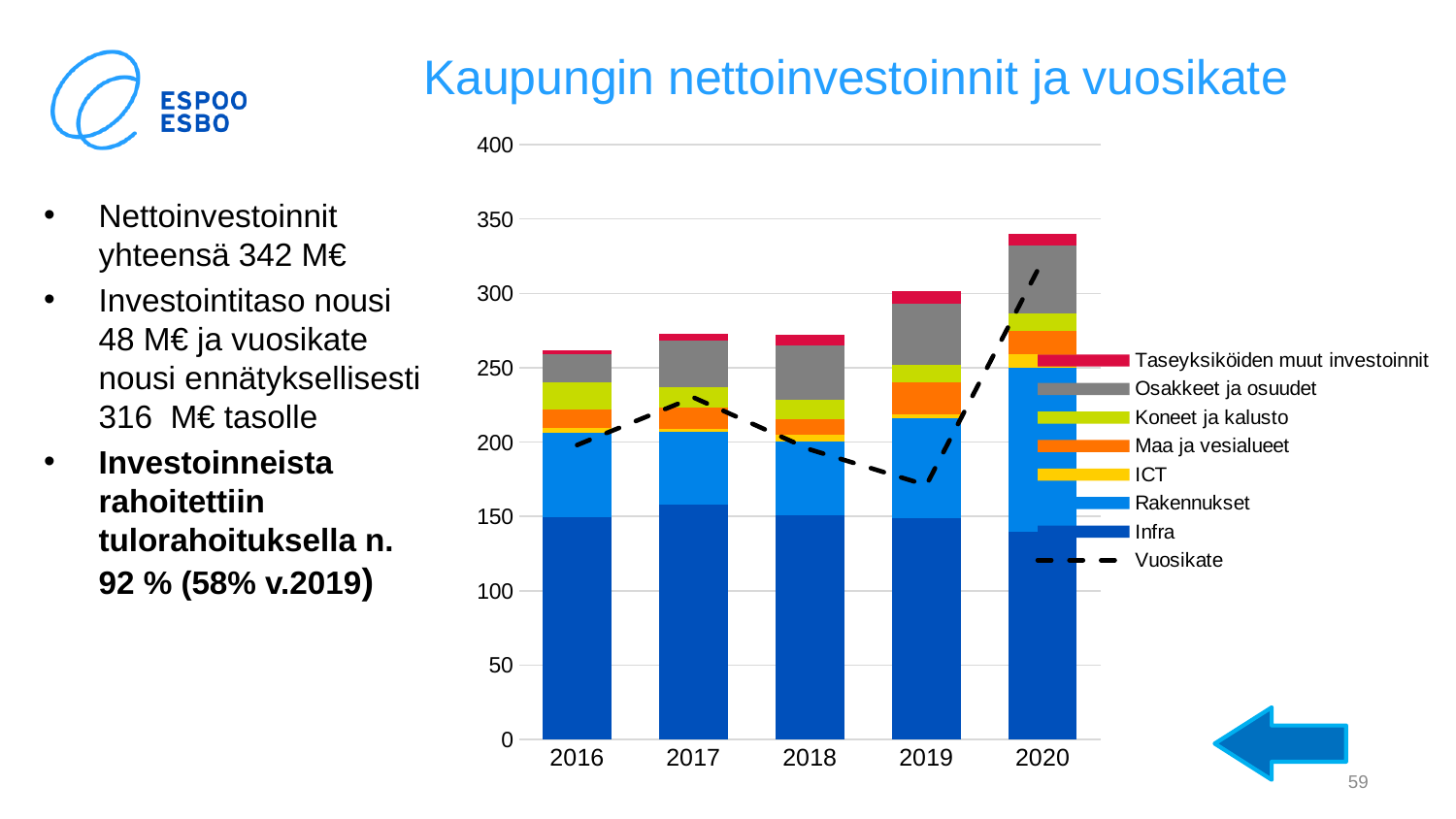
Is the Vuosikate value for 2019 greater or less than 200? less Which series is drawn as a dashed line in the chart? Vuosikate Is the Vuosikate value for 2020 greater or less than 300? greater Which year has the tallest stacked bar? 2020 What is the title of the chart? Kaupungin nettoinvestoinnit ja vuosikate Which stacked bar is taller, 2016 or 2020? 2020 Is the total of the stacked bar for 2016 greater or less than 300? less How many series does the chart legend list? 8 Does the Vuosikate line rise or fall from 2019 to 2020? rise What kind of chart is shown on the slide? Stacked bar chart with a line How many years are shown on the x axis of the chart? 5